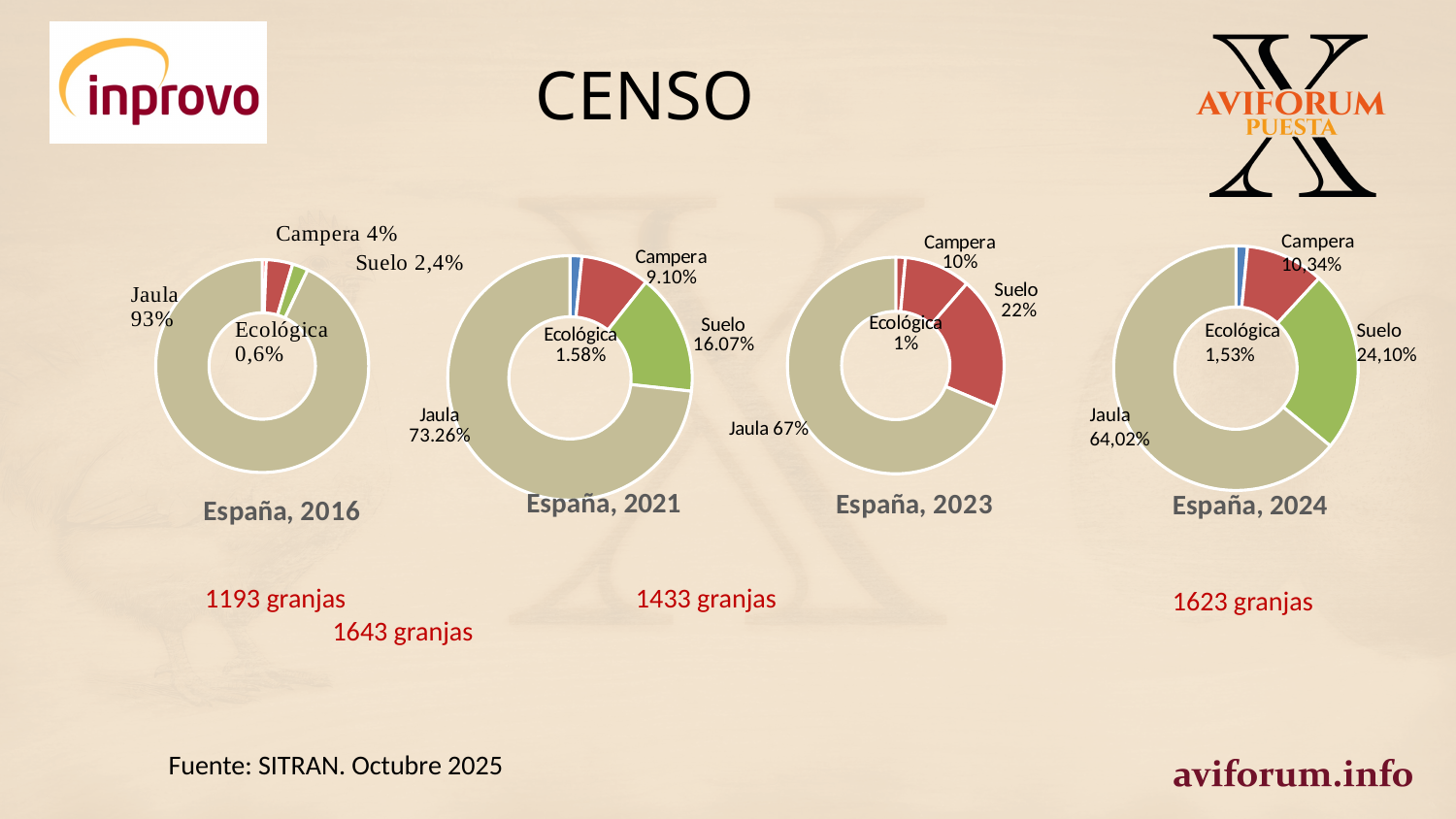
In the España, 2024 chart, what is the share for Ecológica? 1,53% In the España, 2016 chart, which is larger, Campera or Suelo? Campera In the España, 2023 chart, what is the difference in percentage points between Suelo and Campera? 12 How many donut charts are shown on the slide? 4 What kind of chart is used for España, 2021? Donut (pie) chart In the España, 2021 chart, what is the share for Suelo? 16.07% In the España, 2024 chart, which category has the largest share? Jaula In the España, 2023 chart, what is the share for Campera? 10% Across the charts from 2016 to 2024, does the share for Jaula rise or fall? Fall In the España, 2016 chart, what is the share for Jaula? 93% In the España, 2021 chart, which category has the smallest share? Ecológica How many categories does each donut chart show? 4